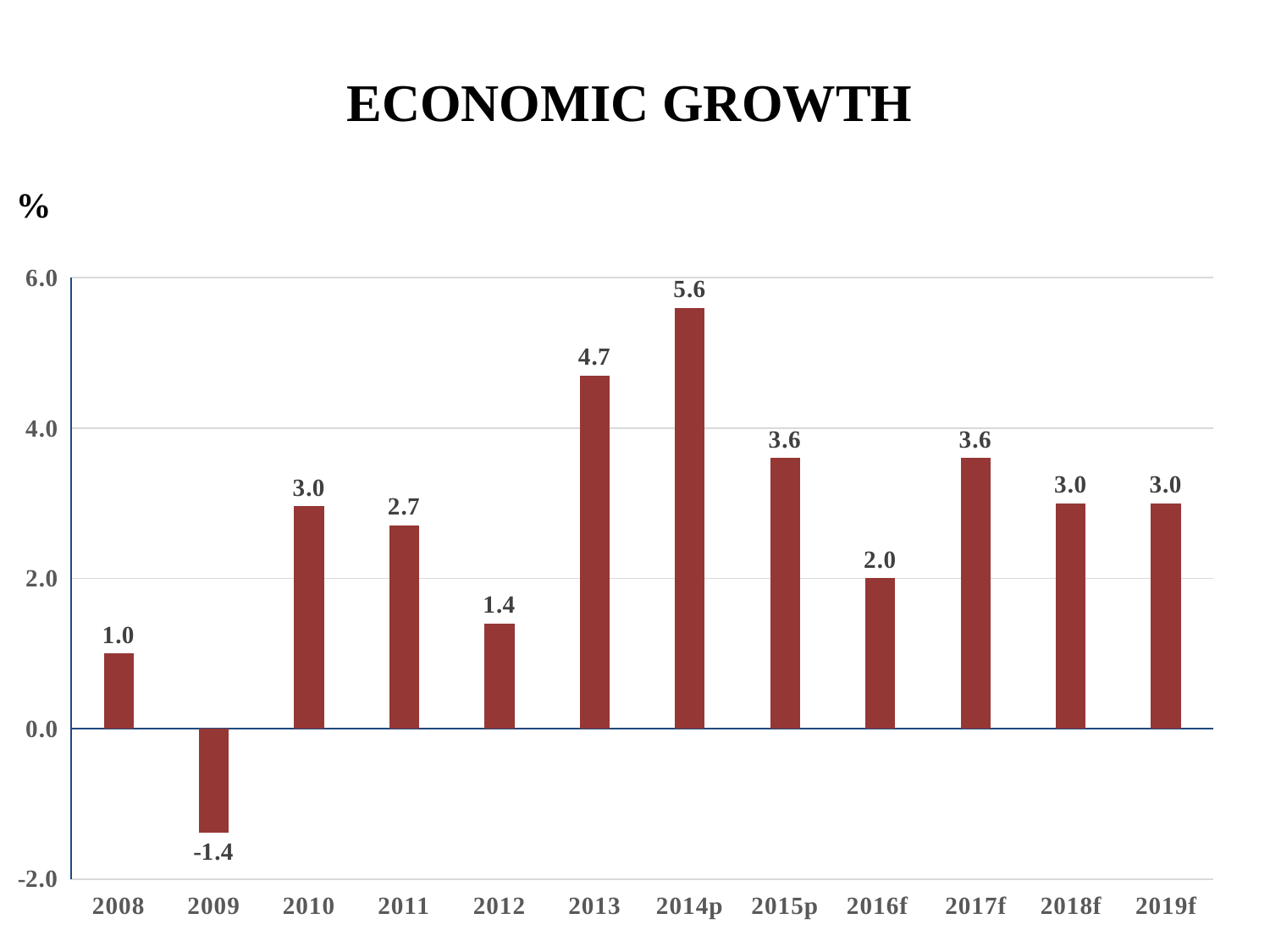
How many years are shown on the x axis? 12 Is the value for 2013 greater or less than 4.0? greater What is the difference between the values for 2014p and 2013? 0.9 What is the title of the chart? ECONOMIC GROWTH What is the value shown for 2016f? 2.0 Which year has the highest economic growth value? 2014p What is the difference between the values for 2015p and 2016f? 1.6 What kind of chart is shown on the slide? bar chart Which year has the lowest economic growth value? 2009 Which is larger, the value for 2011 or the value for 2012? 2011 What is the economic growth value for 2013? 4.7 What is the economic growth value for 2009? -1.4